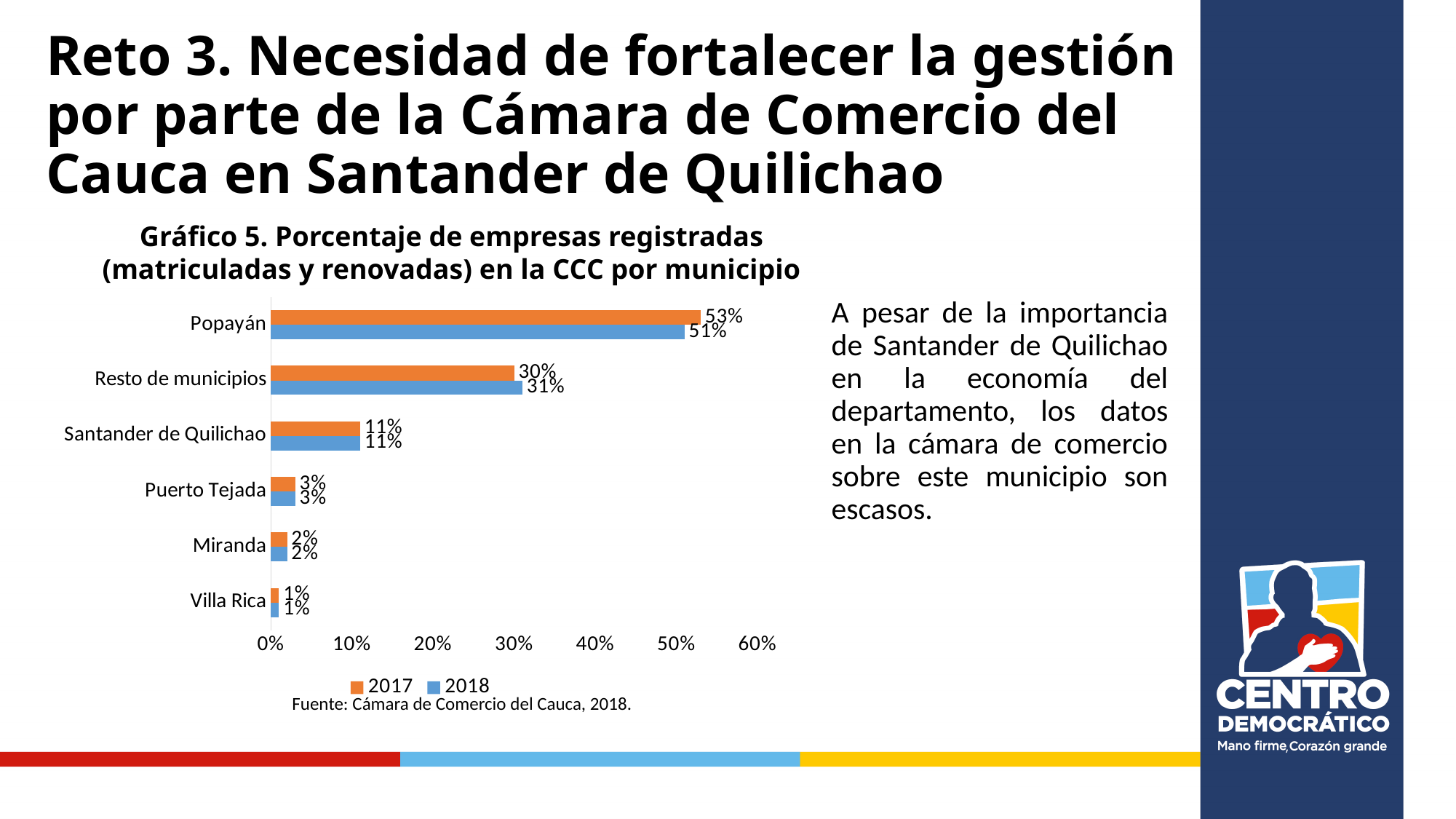
What is the 2018 value for Santander de Quilichao? 11% What is the difference between the 2017 and 2018 values for Popayán? 2% How many categories are shown on the chart? 6 What is the 2018 value for Resto de municipios? 31% Which colour represents the 2018 series? Blue What is the 2017 value for Puerto Tejada? 3% How many series does the legend list? 2 What is the 2017 value for Popayán? 53% What kind of chart is shown? Bar chart Which category has the lowest 2017 value? Villa Rica Which is larger for Resto de municipios, the 2017 value or the 2018 value? 2018 Which category has the highest 2018 value? Popayán